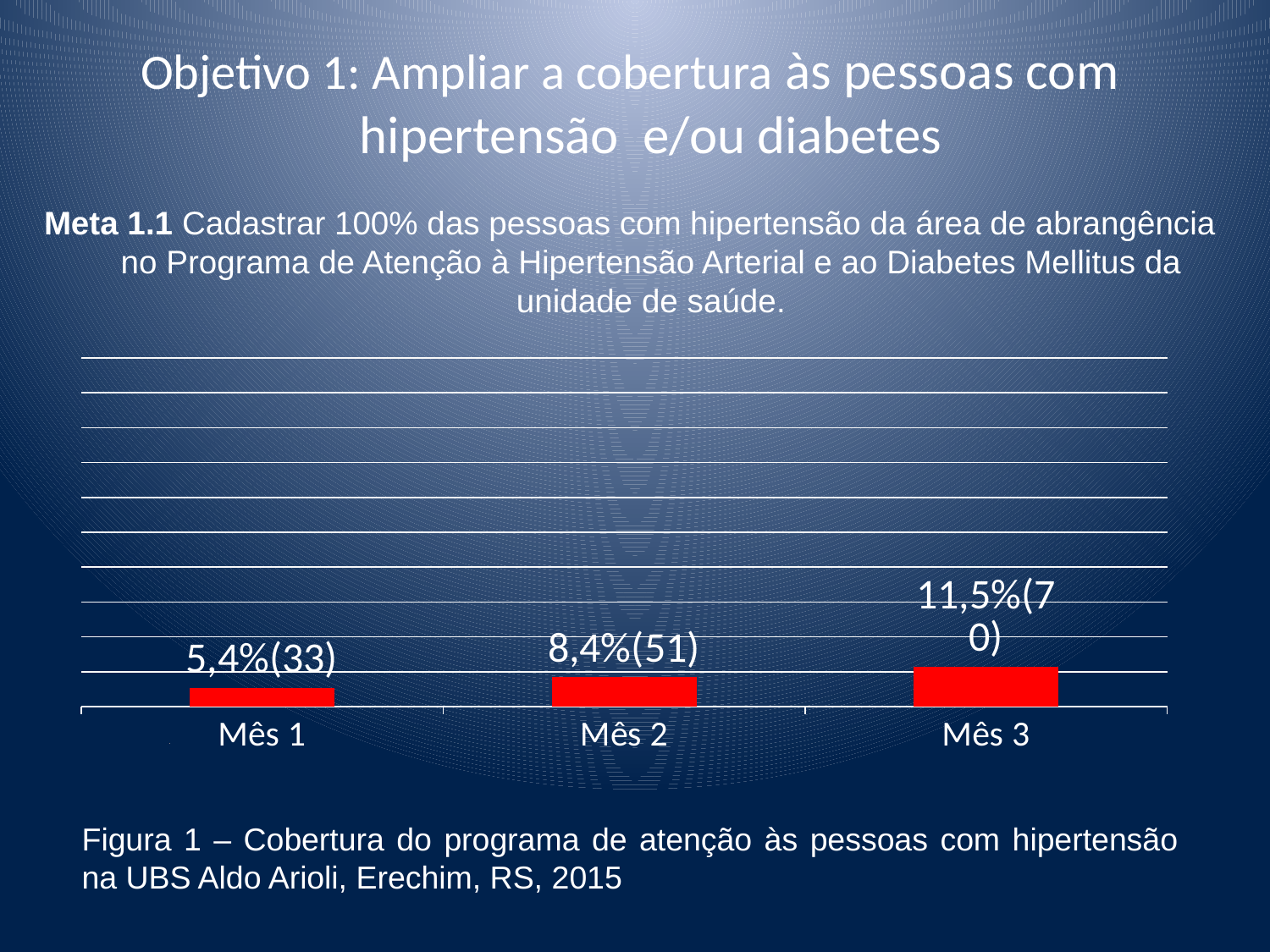
What is the data label shown for Mês 1? 5,4%(33) Do the values rise or fall from Mês 1 to Mês 3? Rise What is the difference in percentage coverage between Mês 3 and Mês 1? 6,1% What kind of chart is shown on the slide? Bar chart How many more people are counted in Mês 3 than in Mês 2, according to the numbers in parentheses? 19 What colour are the bars in the chart? Red What is the data label shown for Mês 2? 8,4%(51) Which month has the highest coverage value? Mês 3 Which month has the lowest coverage value? Mês 1 How many months (categories) are shown on the x axis? 3 What is the data label shown for Mês 3? 11,5%(70) Which is larger, the value for Mês 2 or the value for Mês 1? Mês 2